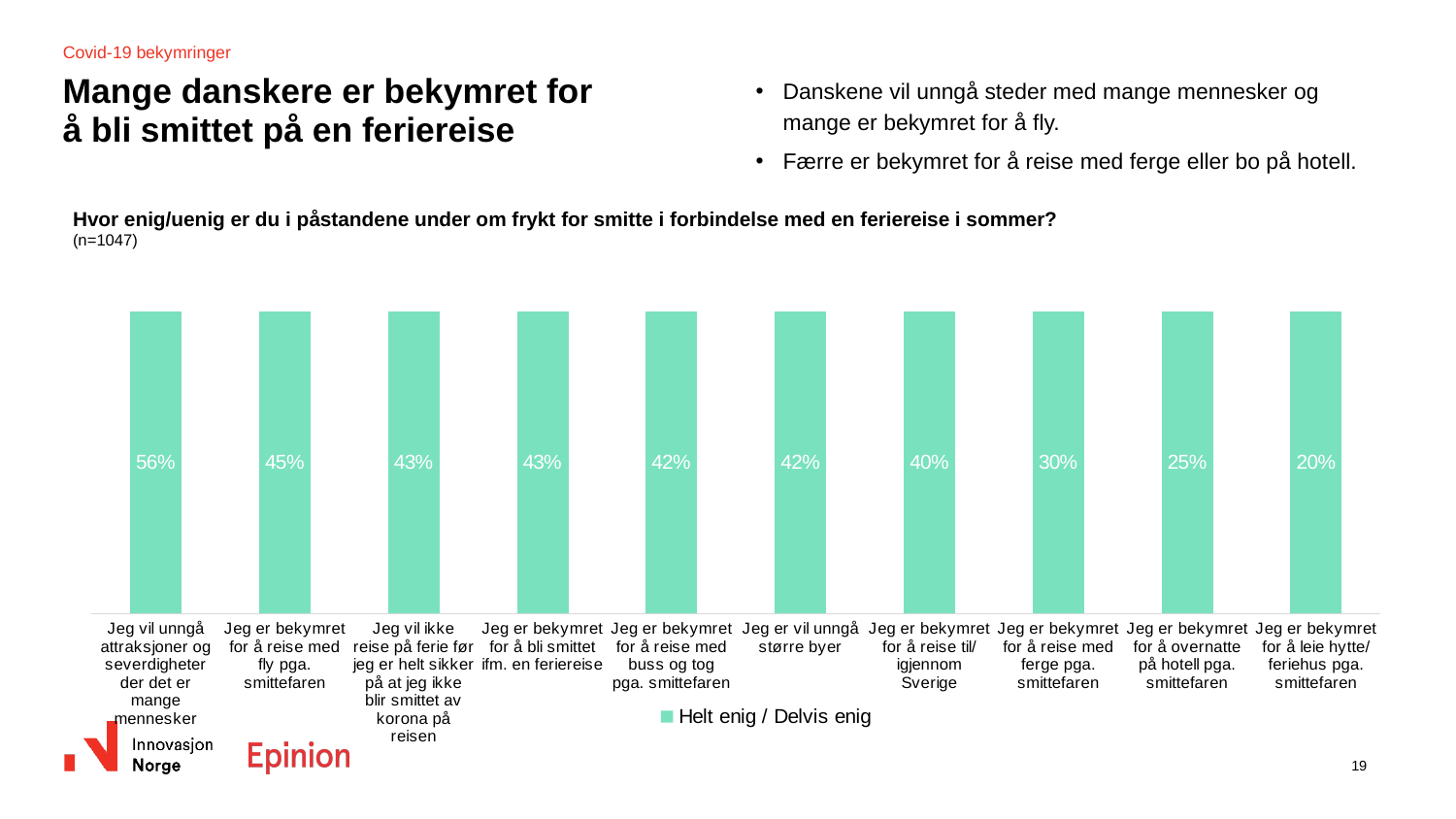
How many statements are shown in the chart? 10 What percentage agree with "Jeg vil unngå attraksjoner og severdigheter der det er mange mennesker"? 56% What is the value shown for "Jeg er bekymret for å reise med fly pga. smittefaren"? 45% Which statement has the highest percentage of agreement? Jeg vil unngå attraksjoner og severdigheter der det er mange mennesker What is the value for "Jeg er bekymret for å reise med ferge pga. smittefaren"? 30% What is the difference between the value for "Jeg er bekymret for å reise med fly pga. smittefaren" and the value for "Jeg er bekymret for å overnatte på hotell pga. smittefaren"? 20 percentage points What percentage is shown for "Jeg er bekymret for å leie hytte/feriehus pga. smittefaren"? 20% Which statement has the lowest percentage of agreement? Jeg er bekymret for å leie hytte/feriehus pga. smittefaren What kind of chart is shown on the slide? Bar chart Which is larger: the value for "Jeg er bekymret for å reise til/igjennom Sverige" or the value for "Jeg er bekymret for å reise med ferge pga. smittefaren"? Jeg er bekymret for å reise til/igjennom Sverige How many series does the legend list? 1 What is the legend entry for the chart? Helt enig / Delvis enig